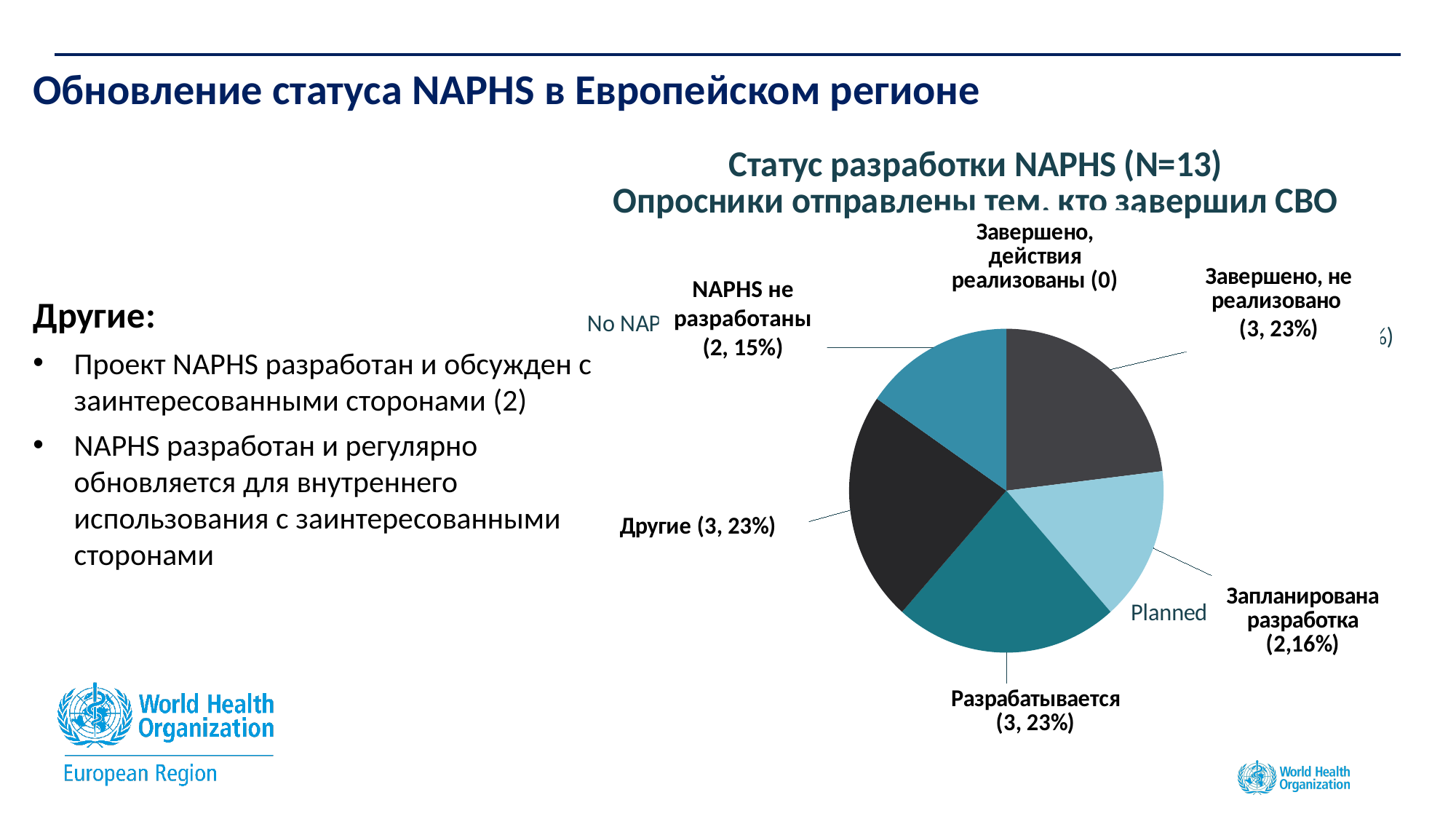
What is the value shown for the category 'Запланирована разработка'? 2,16% What share of the pie does the 'Другие' slice represent? 23% What is the title of the chart? Статус разработки NAPHS (N=13) Опросники отправлены тем, кто завершил СВО What is the value shown for the category 'NAPHS не разработаны'? 2, 15% What is the value shown for the category 'Завершено, действия реализованы'? 0 What is the value shown for the category 'Разрабатывается'? 3, 23% What type of chart is shown on the slide? pie chart What is the total number of responses (N) stated in the chart title? 13 What share of the pie does the 'Завершено, не реализовано' slice represent? 23% Which category has the lowest value in the pie chart? Завершено, действия реализованы Which is larger: the count for 'Разрабатывается' or the count for 'NAPHS не разработаны'? Разрабатывается What is the difference between the count for 'Другие' and the count for 'Запланирована разработка'? 1